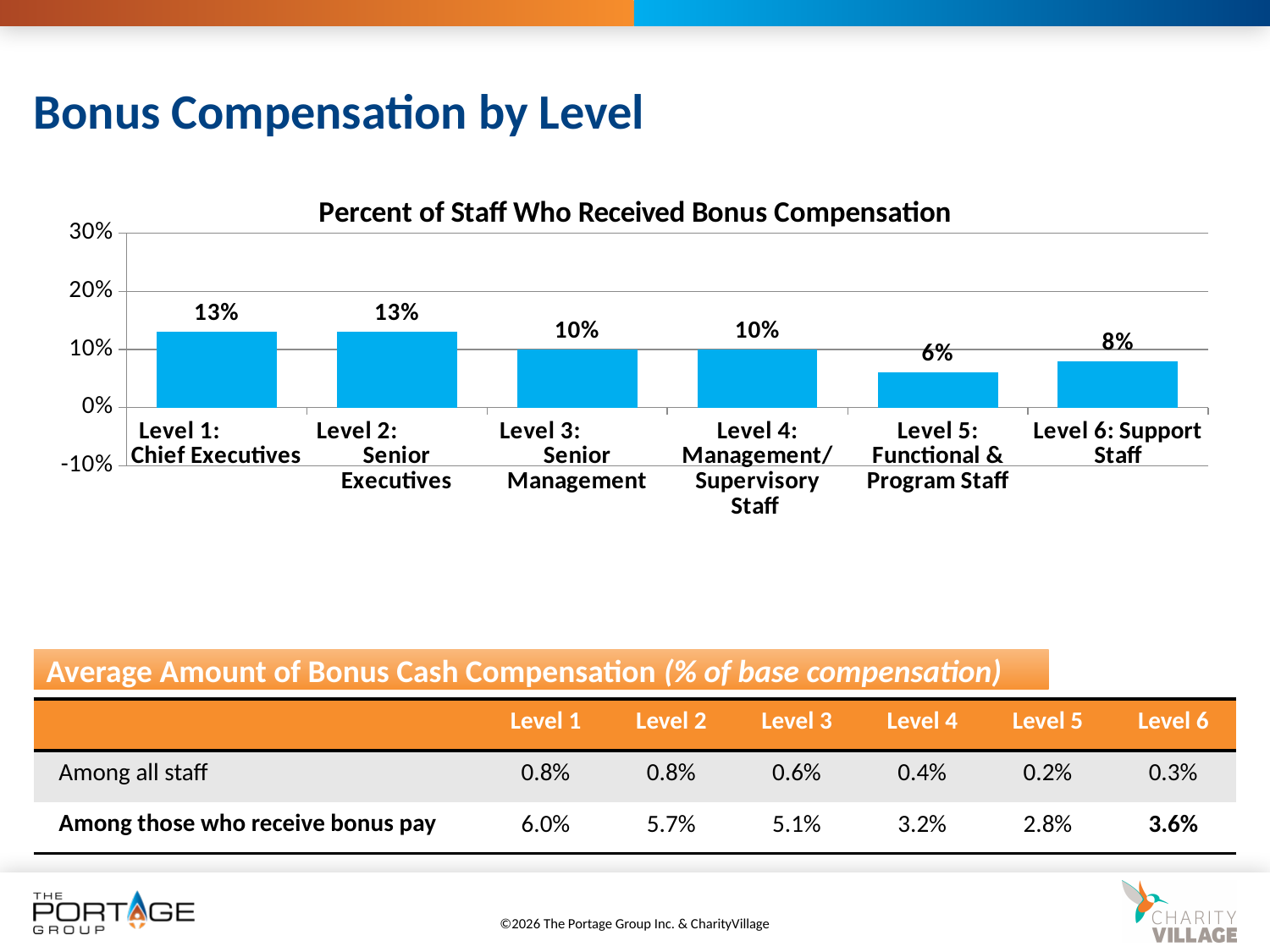
Do the values generally rise or fall from Level 1 to Level 5? Fall What percent of Level 5: Functional & Program Staff received bonus compensation? 6% What percent of Level 3: Senior Management received bonus compensation? 10% What kind of chart is used to show the percent of staff who received bonus compensation? Bar chart Is the value for Level 2: Senior Executives greater or less than 10%? greater What percent of Level 1: Chief Executives received bonus compensation? 13% How many levels are shown in the chart? 6 What is the difference in percentage points between Level 1: Chief Executives and Level 5: Functional & Program Staff? 7 percentage points Which has a higher percent of staff receiving bonus compensation, Level 6: Support Staff or Level 5: Functional & Program Staff? Level 6: Support Staff What percent of Level 6: Support Staff received bonus compensation? 8% Which level has the lowest percent of staff who received bonus compensation? Level 5: Functional & Program Staff What is the title of the chart? Percent of Staff Who Received Bonus Compensation